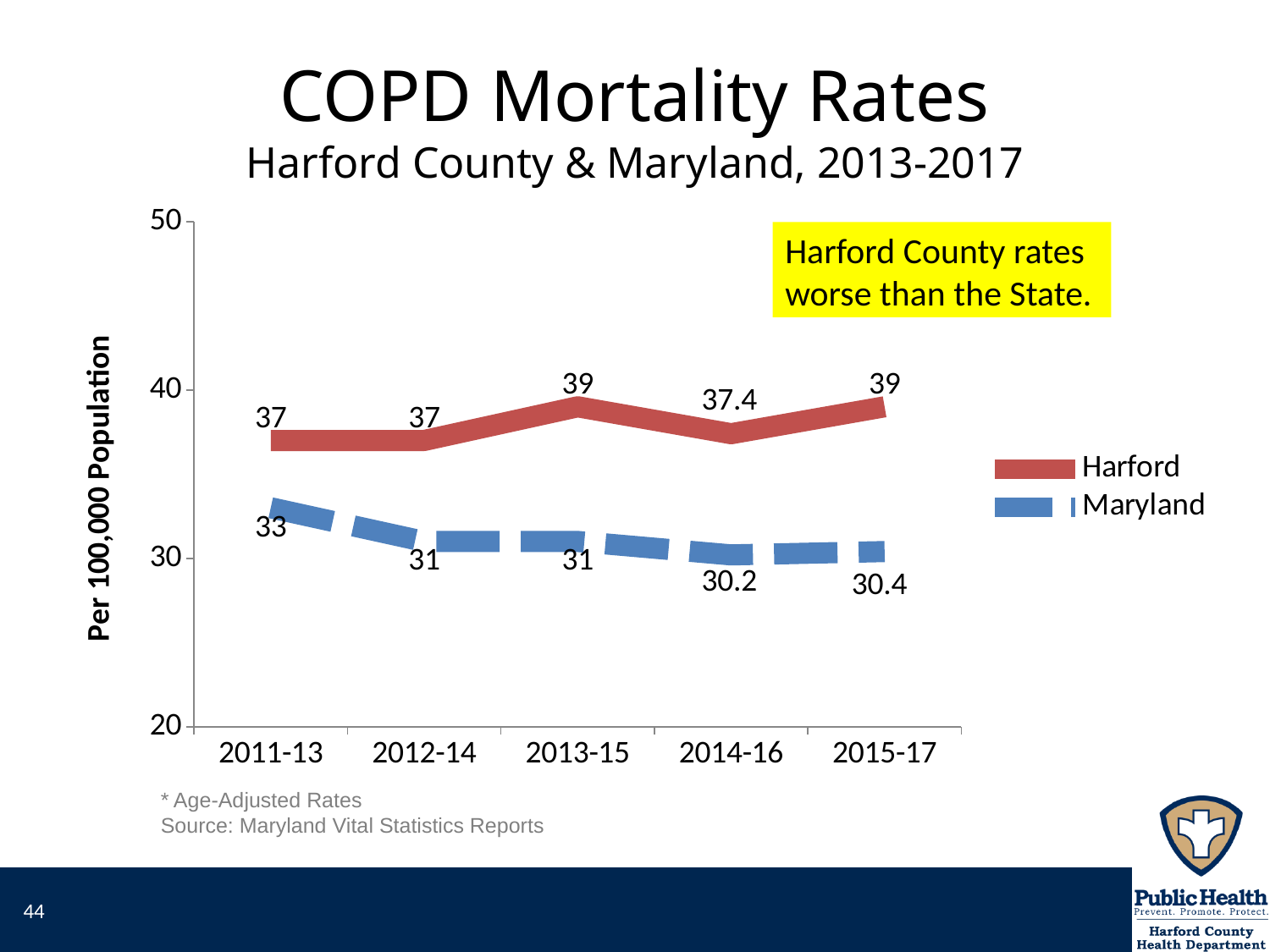
What kind of chart is shown on the slide? Line chart How many series does the legend list? 2 In which period is the Maryland COPD mortality rate highest? 2011-13 What is the Harford COPD mortality rate for 2014-16? 37.4 What is the difference between the Harford and Maryland rates in 2015-17? 8.6 Which series has the higher rate in 2013-15, Harford or Maryland? Harford In which period is the Maryland COPD mortality rate lowest? 2014-16 What is the Maryland COPD mortality rate for 2015-17? 30.4 What is the difference between the Harford and Maryland rates in 2011-13? 4 What is the Harford COPD mortality rate for 2013-15? 39 What is the Maryland COPD mortality rate for 2011-13? 33 How many time periods are shown on the x axis? 5